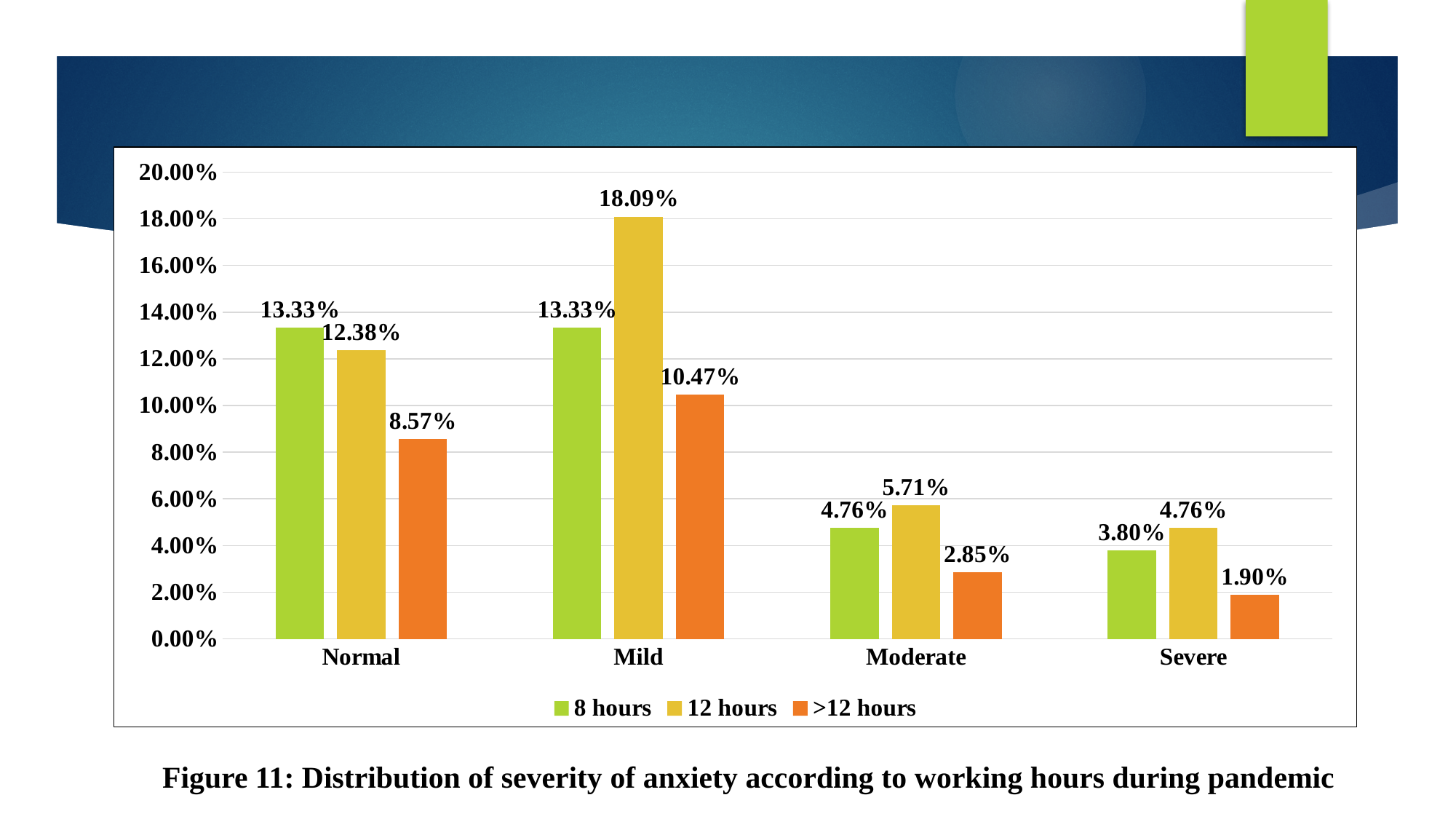
How many series does the legend list? 3 How many categories are shown on the x axis? 4 What is the value for 8 hours in the Severe category? 3.80% What is the difference between the 12 hours and >12 hours values in the Mild category? 7.62% What is the value for >12 hours in the Normal category? 8.57% Which category has the highest value for the 12 hours series? Mild What is the value for 12 hours in the Mild category? 18.09% What is the caption of the figure shown on the slide? Figure 11: Distribution of severity of anxiety according to working hours during pandemic Which category has the lowest value for the >12 hours series? Severe Which is larger in the Moderate category: the 8 hours value or the 12 hours value? 12 hours Do the values for the 12 hours series rise or fall from Mild to Severe? Fall What kind of chart is shown on the slide? Bar chart